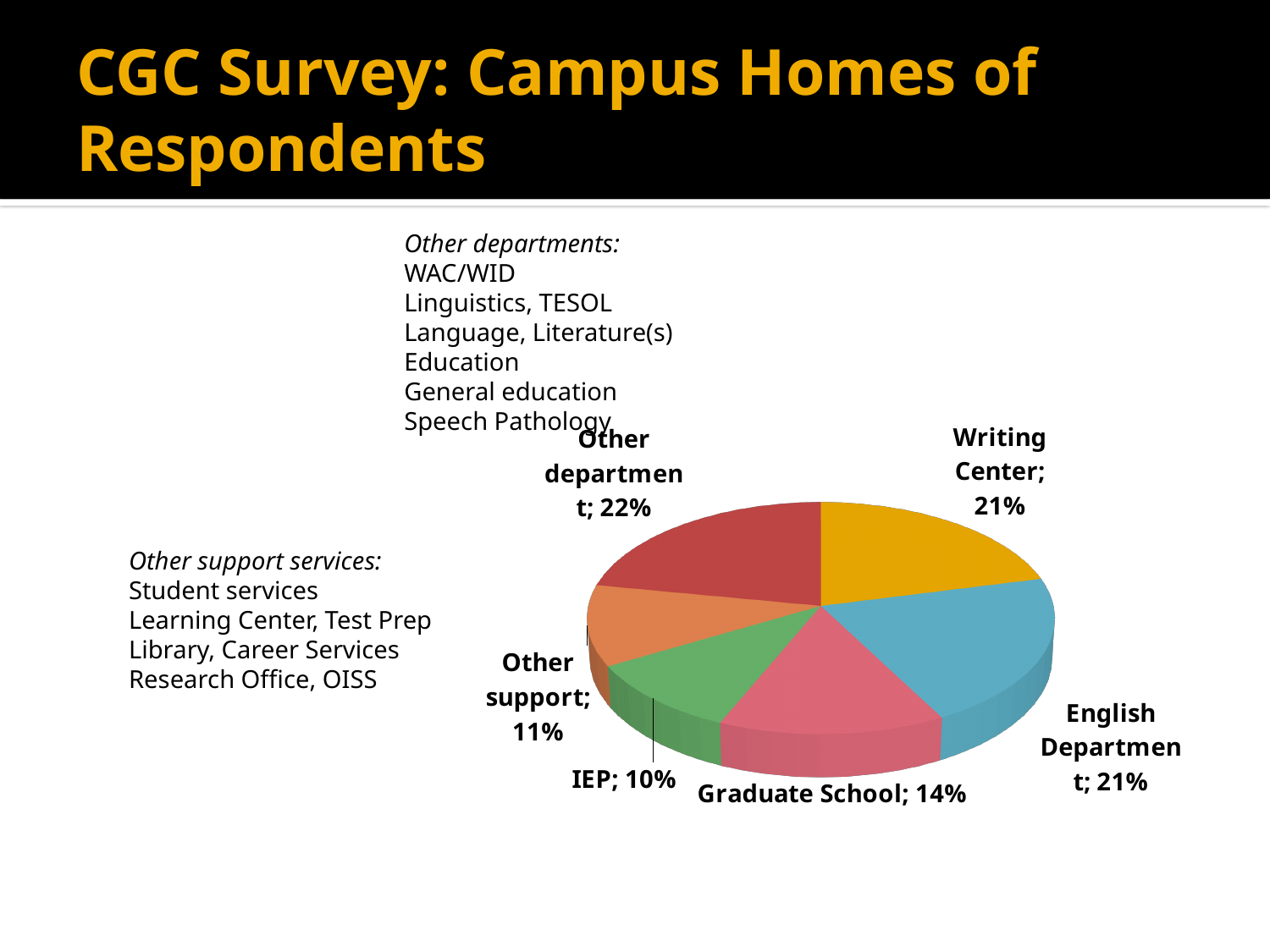
What kind of chart is shown on the slide? Pie chart What share of the pie is labelled 'Other support'? 11% How many slices does the pie chart have? 6 Which category has the smallest share of respondents? IEP Which category has the largest share of respondents? Other department What is the title of the slide containing the pie chart? CGC Survey: Campus Homes of Respondents What percentage of respondents are from IEP? 10% What percentage of respondents are from the Graduate School? 14% What percentage of respondents are from the Writing Center? 21% What is the difference in percentage points between the English Department share and the Graduate School share? 7 percentage points What is the difference in percentage points between the Other department share and the IEP share? 12 percentage points Which is larger, the share for Graduate School or the share for IEP? Graduate School